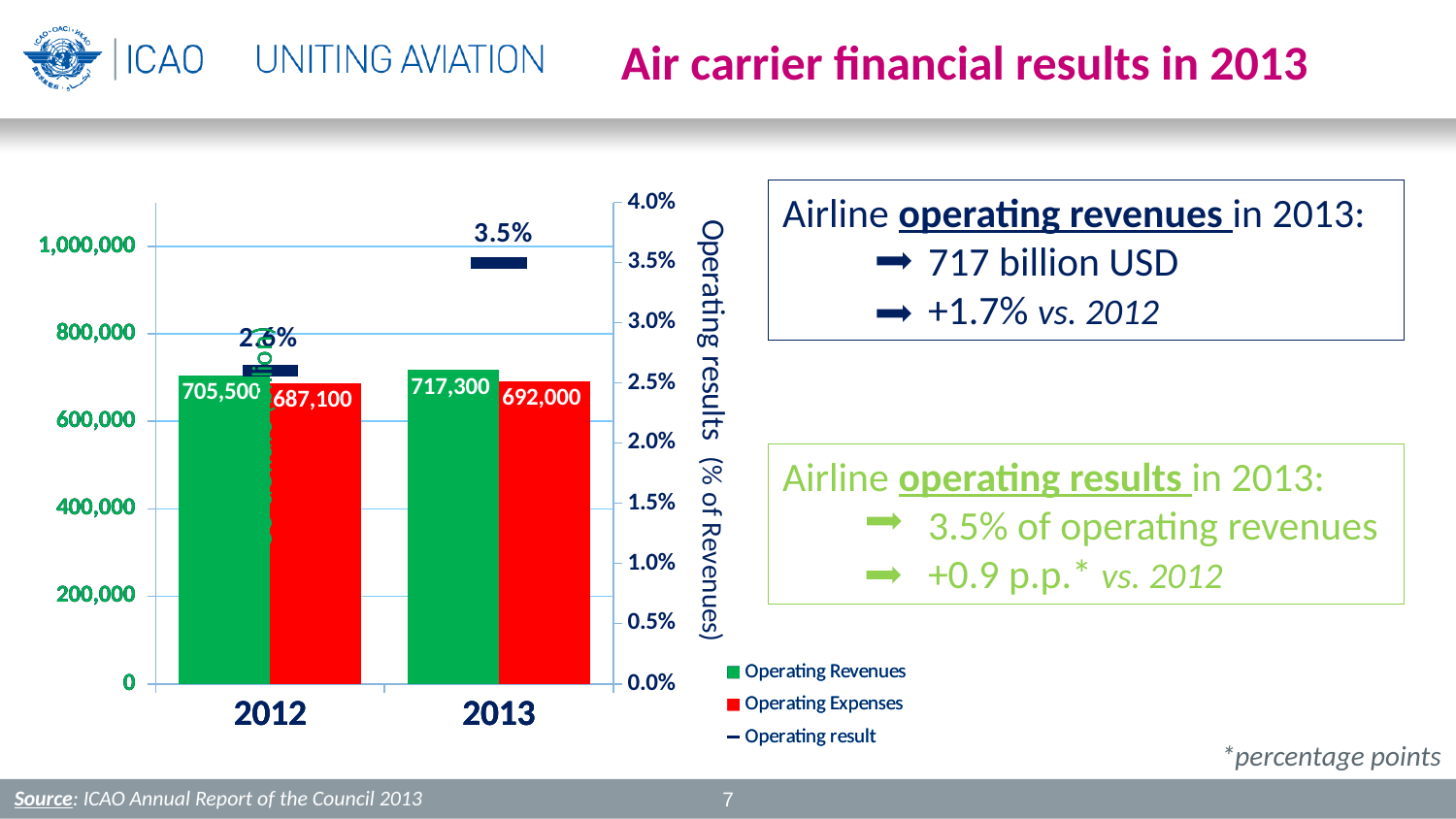
What is the value of Operating Revenues for 2012? 705,500 What is the value of Operating Revenues for 2013? 717,300 How many years are shown on the x axis? 2 By how much did Operating Revenues increase from 2012 to 2013? 11,800 What is the Operating result for 2013, as a percentage of revenues? 3.5% What kind of chart is used to show Operating Revenues and Operating Expenses? bar chart Which year has the higher Operating Expenses, 2012 or 2013? 2013 How many series does the legend list? 3 What is the difference between Operating Revenues and Operating Expenses in 2013? 25,300 Is the Operating result for 2012 greater or less than 3.0%? less What is the value of Operating Expenses for 2012? 687,100 Which colour represents Operating Expenses in the legend? red